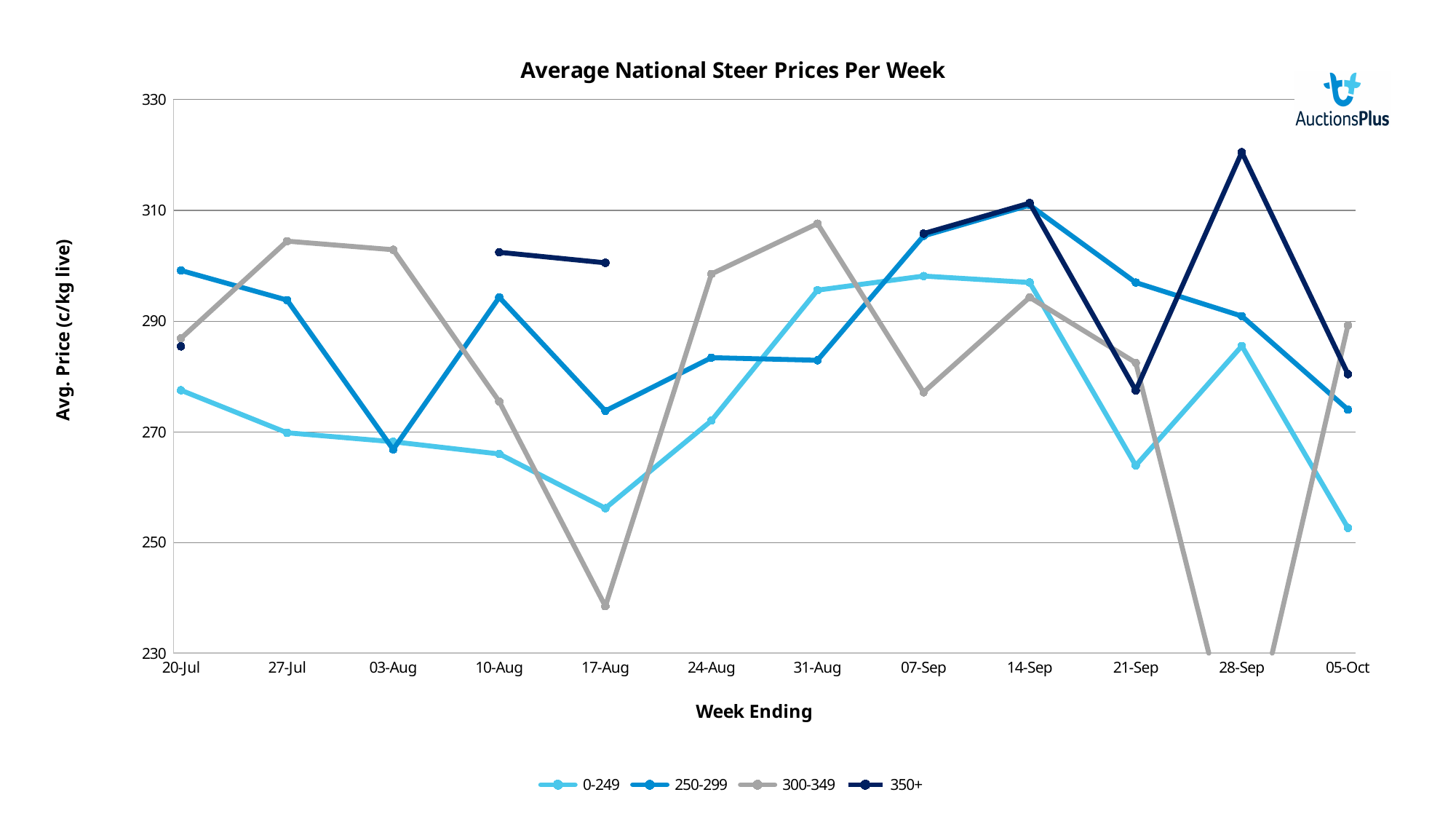
Is the value for the 0-249 series at 17-Aug greater or less than 270? less Which week has the lowest value for the 300-349 series? 28-Sep Is the value for the 350+ series at 28-Sep greater or less than 310? greater Does the 0-249 series rise or fall from 20-Jul to 17-Aug? fall Which week has the highest value for the 350+ series? 28-Sep Is the value for the 250-299 series at 20-Jul greater or less than 290? greater What is the title of the y axis? Avg. Price (c/kg live) How many week-ending dates are shown on the x axis? 12 What kind of chart is shown on the slide? line chart At 20-Jul, which series has the larger value: 0-249 or 250-299? 250-299 How many series does the legend list? 4